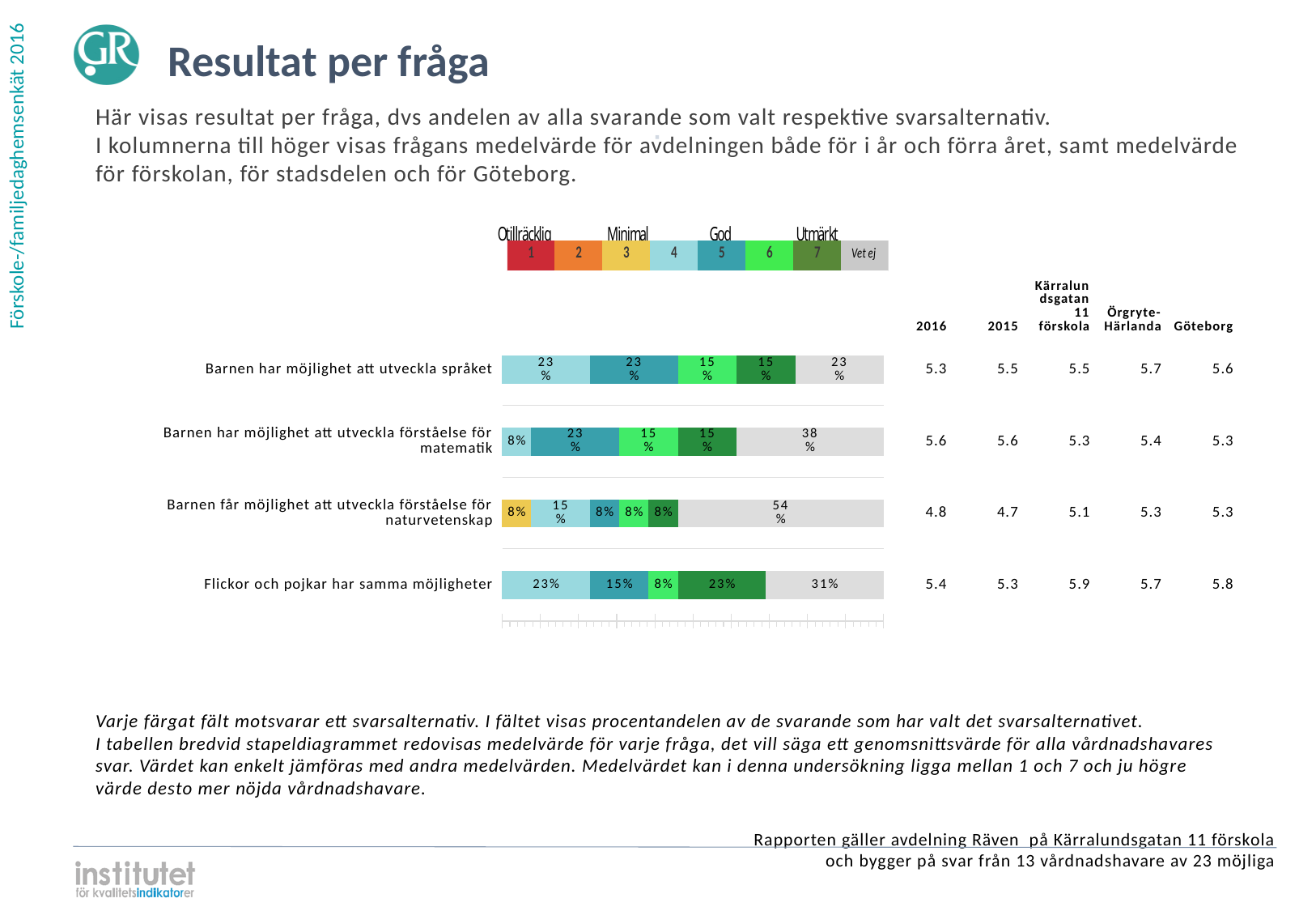
Which is larger: the share choosing answer 7 for 'Flickor och pojkar har samma möjligheter' or for 'Barnen får möjlighet att utveckla förståelse för naturvetenskap'? Flickor och pojkar har samma möjligheter What percentage of respondents chose answer 7 (Utmärkt) for 'Flickor och pojkar har samma möjligheter'? 23% What is the Göteborg mean value for 'Flickor och pojkar har samma möjligheter'? 5.8 How many answer alternatives does the legend above the chart list? 8 What is the difference between the 'Vet ej' share for 'Barnen har möjlighet att utveckla förståelse för matematik' and for 'Barnen har möjlighet att utveckla språket'? 15 percentage points What is the 2016 mean value for 'Barnen får möjlighet att utveckla förståelse för naturvetenskap'? 4.8 What percentage of respondents chose answer 4 for 'Barnen har möjlighet att utveckla förståelse för matematik'? 8% How many questions (categories) are shown in the bar chart? 4 Which question has the smallest 'Vet ej' share? Barnen har möjlighet att utveckla språket What percentage of respondents answered 'Vet ej' for 'Barnen får möjlighet att utveckla förståelse för naturvetenskap'? 54% Which question has the largest 'Vet ej' share? Barnen får möjlighet att utveckla förståelse för naturvetenskap What kind of chart is used to show the results per question? Stacked bar chart